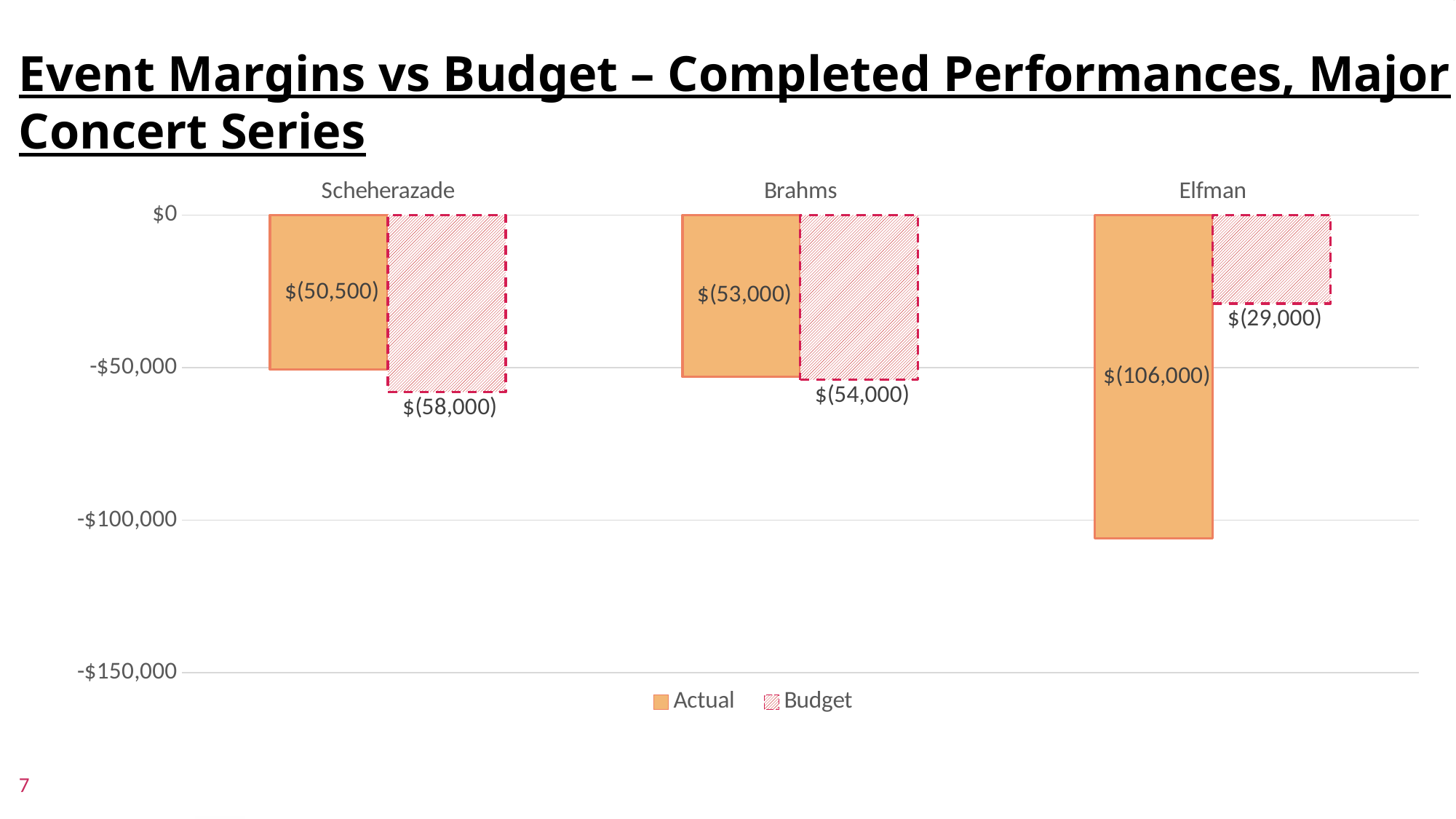
What is the Budget margin for Elfman? $(29,000) Which performance has the most negative Actual margin? Elfman What is the Actual margin for Scheherazade? $(50,500) Which performance has the least negative Budget margin? Elfman What is the Actual margin for Brahms? $(53,000) What type of chart is shown on the slide? Bar chart What is the Budget margin for Scheherazade? $(58,000) How many performances are shown on the chart? 3 What is the difference between the Budget and Actual margins for Scheherazade? $7,500 By how much does the Actual margin for Elfman differ from its Budget margin? $77,000 Is the Actual margin for Elfman more negative than the Budget margin for Elfman? Yes How many series does the legend list? 2